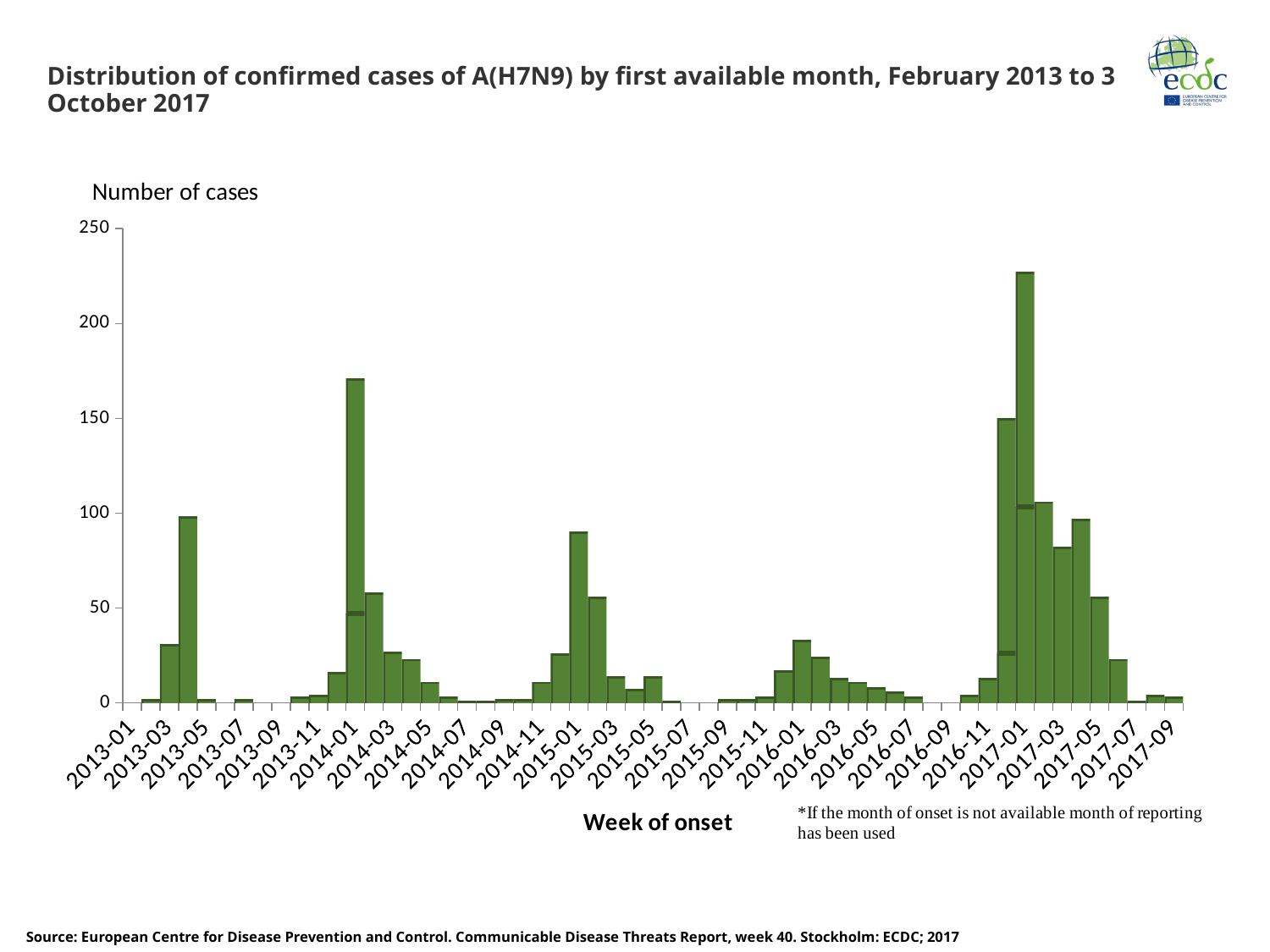
In which year does the tallest bar of the chart occur? 2017 What is the label of the vertical axis? Number of cases Is the value of the tallest bar in early 2014 greater or less than 150? greater What is the highest value shown on the vertical axis? 250 Is the value of the tallest bar in early 2015 greater or less than 100? less Do the values rise or fall from 2017-01 to 2017-09? fall Is the value of the tallest bar (early 2017) greater or less than 200? greater What kind of chart is shown on the slide? bar chart Which is larger, the peak in early 2014 or the peak in early 2015? the peak in early 2014 Which is larger, the peak in early 2016 or the peak in early 2017? the peak in early 2017 What is the label of the horizontal axis? Week of onset